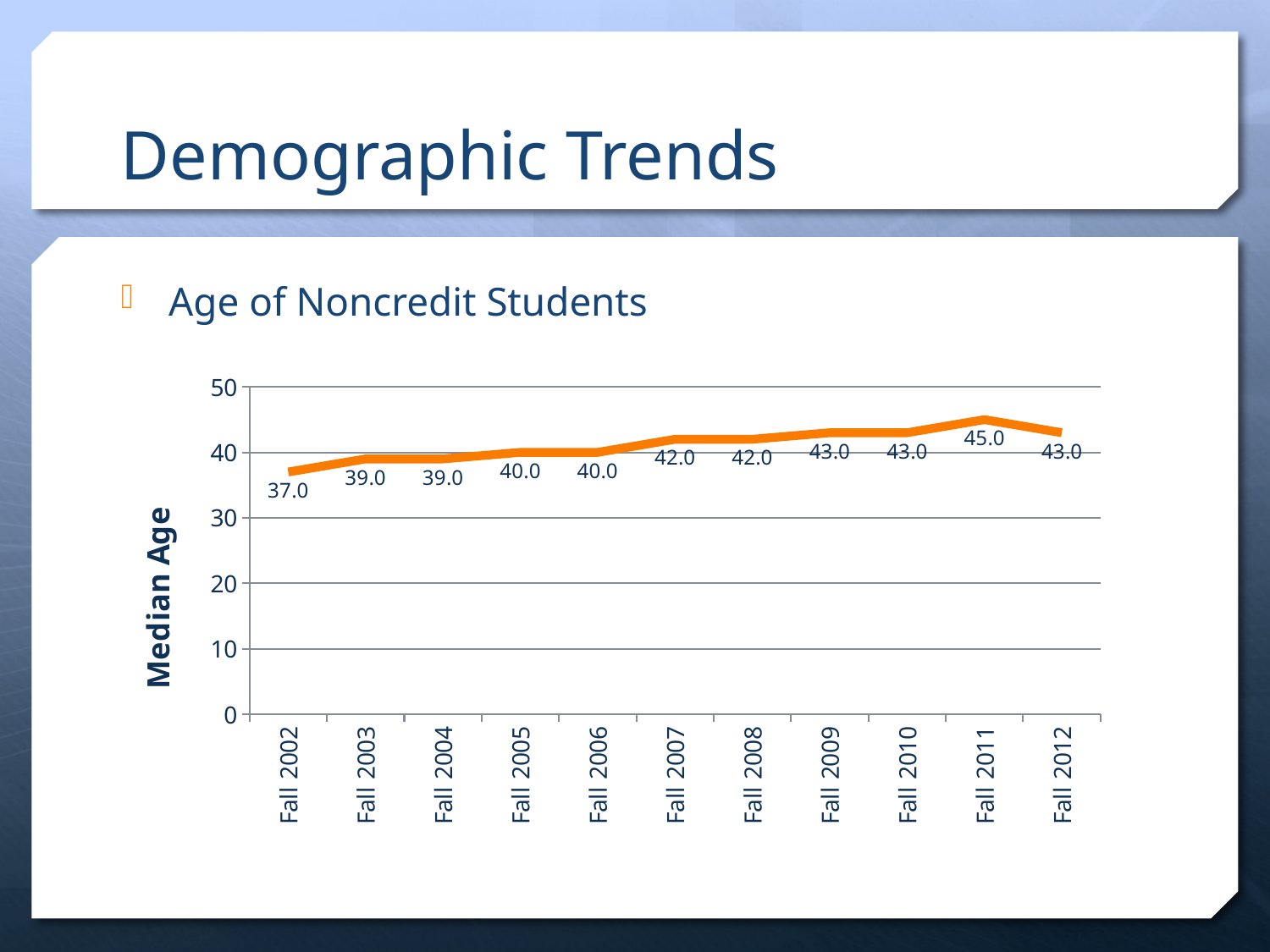
What is the label on the vertical axis of the chart? Median Age Which is larger, the median age in Fall 2009 or in Fall 2005? Fall 2009 What is the median age of noncredit students in Fall 2002? 37.0 What is the difference in median age between Fall 2011 and Fall 2002? 8.0 In which term is the median age of noncredit students highest? Fall 2011 How many terms are plotted on the x axis of the chart? 11 What is the median age of noncredit students in Fall 2011? 45.0 In which term is the median age of noncredit students lowest? Fall 2002 What kind of chart is shown on the slide? Line chart What is the median age of noncredit students in Fall 2007? 42.0 Does the median age of noncredit students generally rise or fall from Fall 2002 to Fall 2011? Rise What is the median age of noncredit students in Fall 2012? 43.0